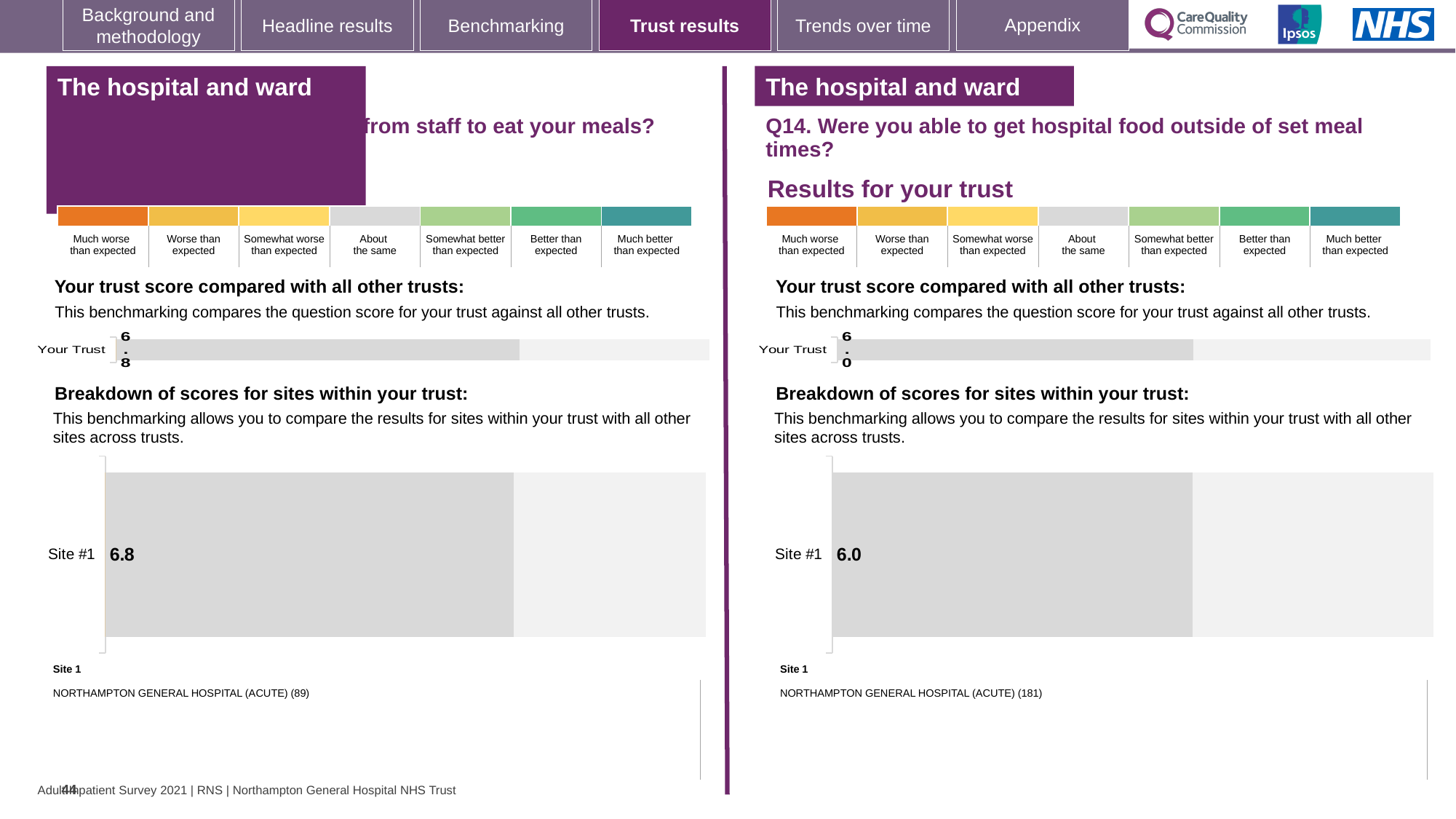
On the right-hand side of the slide (Q14), what is the score shown for Your Trust in the 'Your trust score compared with all other trusts' chart? 6.0 Which site name is listed as Site 1 beneath the right-hand (Q14) breakdown chart? NORTHAMPTON GENERAL HOSPITAL (ACUTE) (181) Which is larger: the Site #1 score in the left-hand breakdown chart or the Site #1 score in the right-hand (Q14) breakdown chart? Left-hand chart (6.8) What is the difference between the Site #1 score in the left-hand breakdown chart (6.8) and the Site #1 score in the right-hand Q14 breakdown chart (6.0)? 0.8 On the left-hand side of the slide, what is the score shown for Your Trust in the 'Your trust score compared with all other trusts' chart? 6.8 How many sites are plotted in the left-hand 'Breakdown of scores for sites within your trust' chart? 1 On the left-hand side of the slide, what is the score shown for Site #1 in the 'Breakdown of scores for sites within your trust' chart? 6.8 How many sites are plotted in the right-hand (Q14) 'Breakdown of scores for sites within your trust' chart? 1 In the right-hand (Q14) breakdown chart, which site label is shown next to the bar? Site #1 On the right-hand side of the slide (Q14), what is the score shown for Site #1 in the 'Breakdown of scores for sites within your trust' chart? 6.0 What type of chart is used to show the Site #1 score in the 'Breakdown of scores for sites within your trust' section on the right-hand side? Bar chart